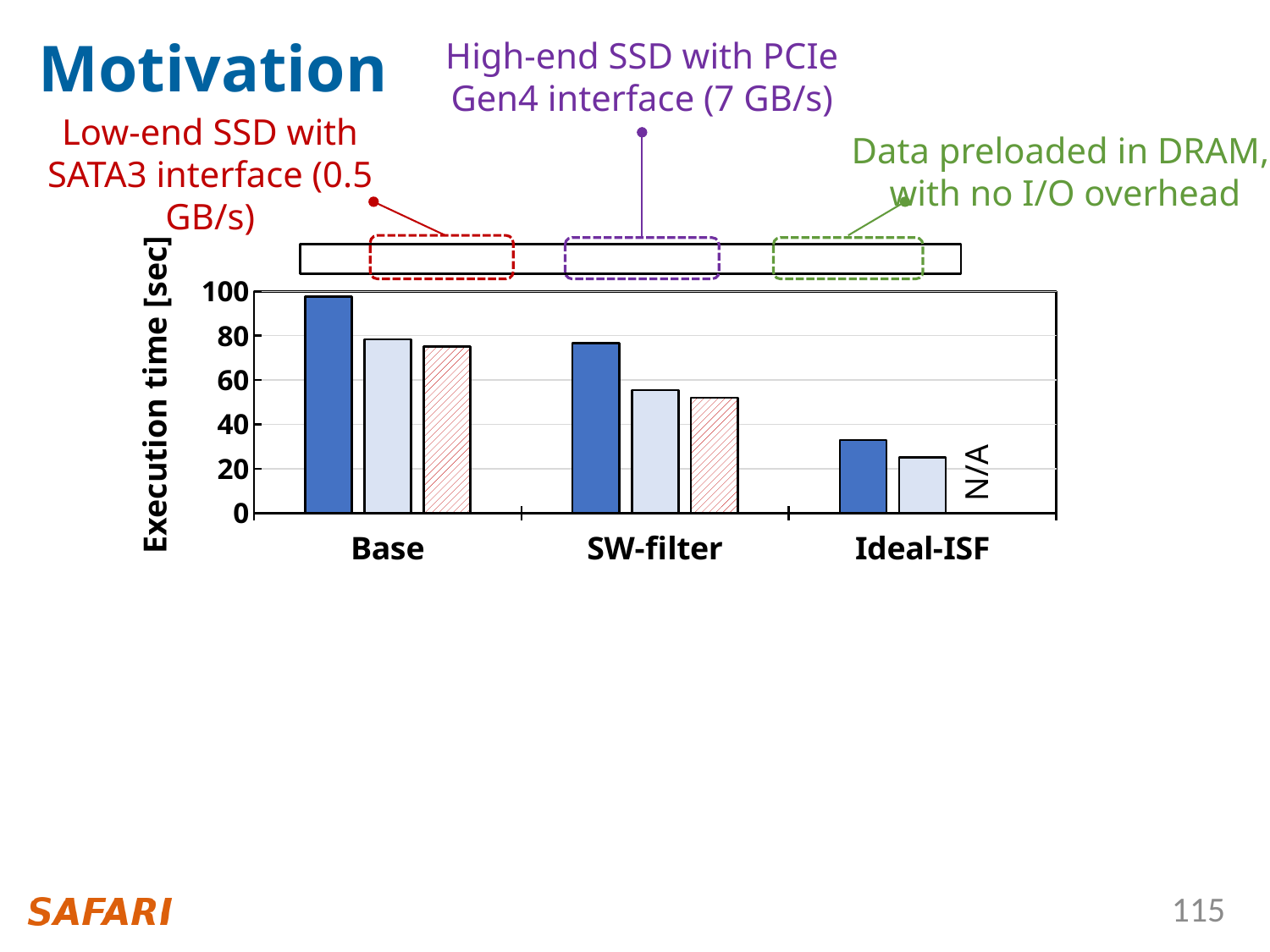
Which category is marked with N/A for one of its bars? Ideal-ISF Is the value of the dark blue bar for SW-filter greater or less than 60? greater What is the label of the y axis of the chart? Execution time [sec] Which category has the tallest bar in the chart? Base Which has the larger dark blue bar, Base or SW-filter? Base Is the value of the light blue bar for Ideal-ISF greater or less than 40? less Is the value of the dark blue bar for Base greater or less than 80? greater What kind of chart is shown on the slide? bar chart Do the dark blue bars rise or fall from Base to Ideal-ISF along the x axis? fall How many categories are shown on the x axis of the chart? 3